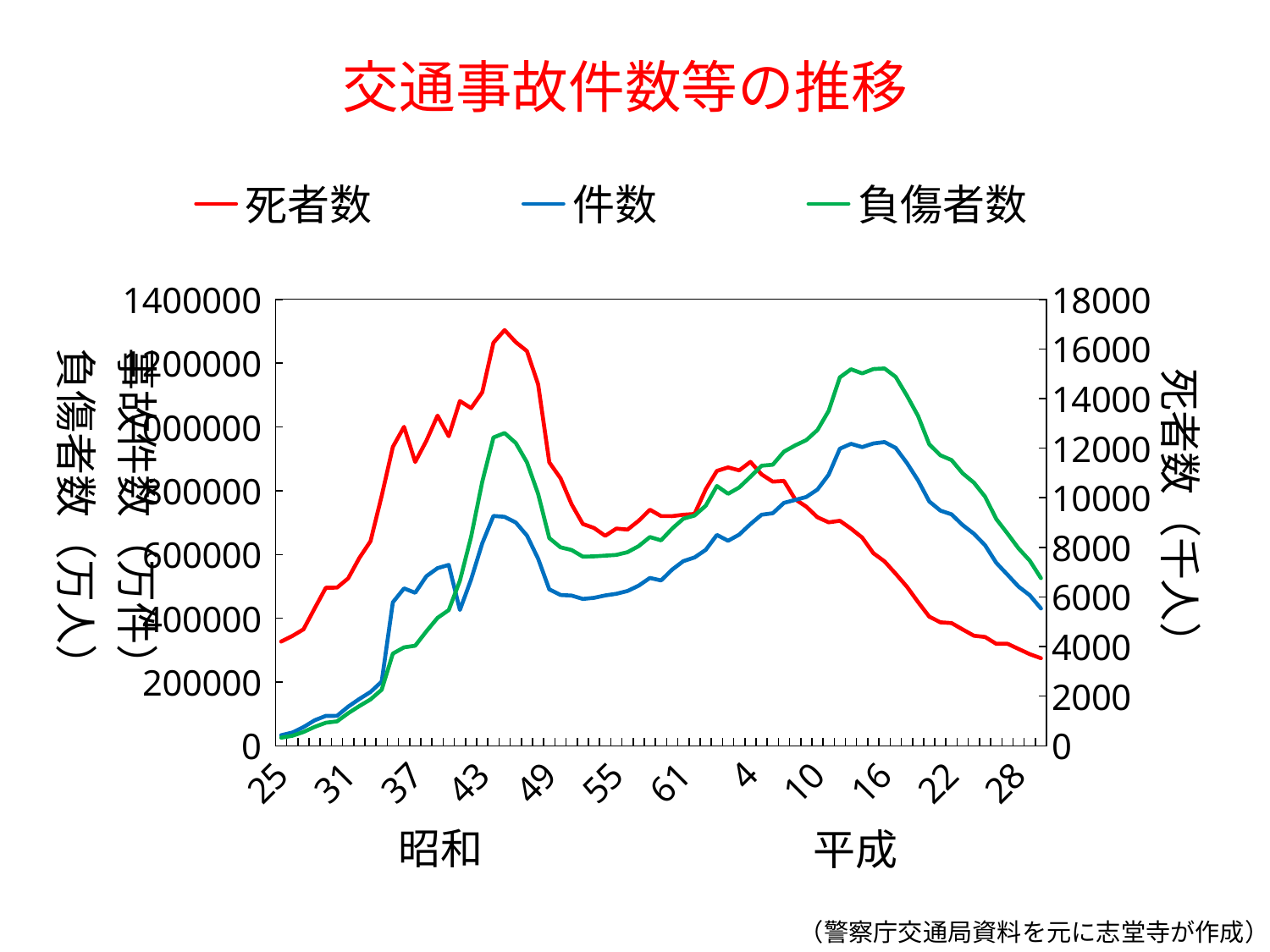
What is the title of the chart? 交通事故件数等の推移 Is the value for 死者数 at 昭和45 greater or less than 14000 (right axis)? greater Does 負傷者数 rise or fall from 昭和25 to 昭和45? rise At 昭和45, which is larger on the left axis: 件数 or 負傷者数? 負傷者数 Which series is drawn in green? 負傷者数 At 平成16, which is larger on the left axis: 件数 or 負傷者数? 負傷者数 Does 死者数 rise or fall from 平成16 to 平成30? fall What kind of chart is shown on the slide? line chart How many series does the legend list? 3 Is the value for 件数 at 平成16 greater or less than 1000000? less Is the value for 死者数 at 平成28 greater or less than 6000 (right axis)? less